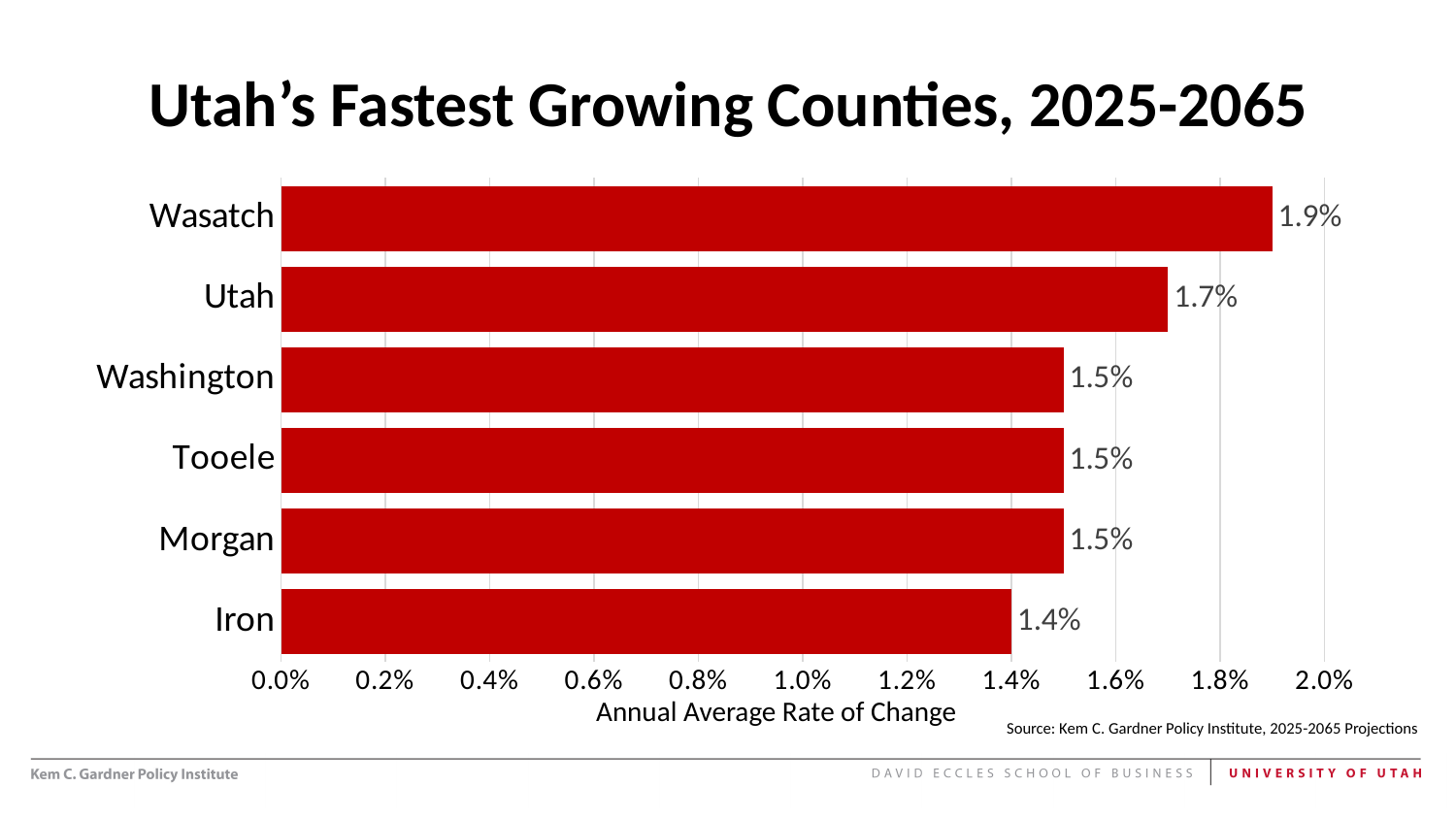
What is the annual average rate of change for Iron County? 1.4% How many counties are shown in the chart? 6 Which county has the lowest annual average rate of change? Iron What is the annual average rate of change for Utah County? 1.7% Which county has the highest annual average rate of change? Wasatch What is the annual average rate of change for Tooele County? 1.5% Which has a higher annual average rate of change, Utah or Washington? Utah What is the difference between the rates for Wasatch and Utah counties? 0.2% What is the label on the horizontal axis of the chart? Annual Average Rate of Change What is the annual average rate of change for Wasatch County? 1.9% What type of chart is shown on the slide? Bar chart What is the difference between the rates for Wasatch and Iron counties? 0.5%